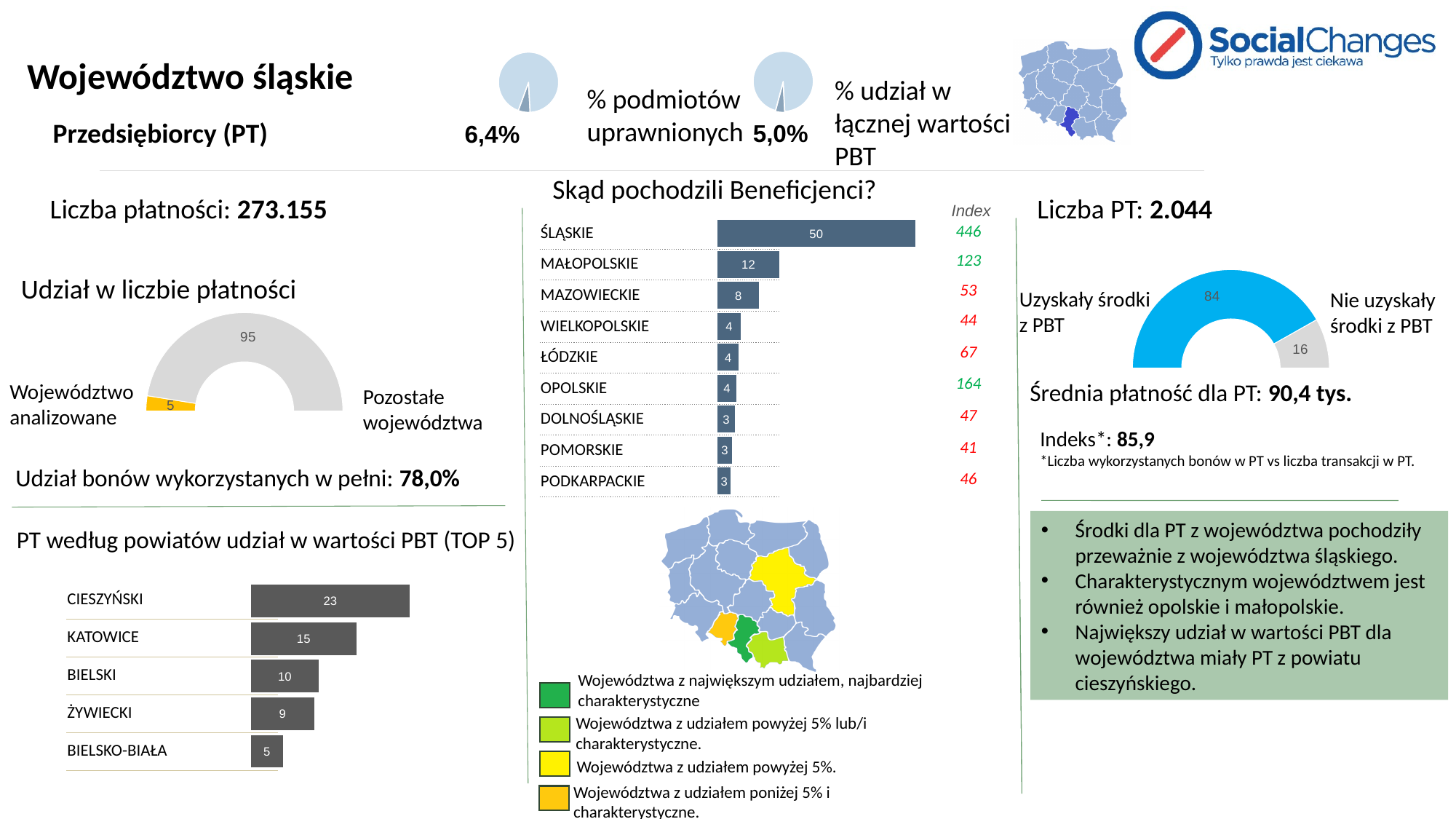
In the 'Skąd pochodzili Beneficjenci?' chart, which voivodeship has the highest value? ŚLĄSKIE In the 'Skąd pochodzili Beneficjenci?' chart, what is the value for ŚLĄSKIE? 50 In the 'Udział w liczbie płatności' chart, what is the value for 'Pozostałe województwa'? 95 What kind of chart is 'PT według powiatów udział w wartości PBT (TOP 5)'? Bar chart In the 'PT według powiatów udział w wartości PBT (TOP 5)' chart, which is larger: CIESZYŃSKI or BIELSKI? CIESZYŃSKI In the chart next to 'Liczba PT: 2.044', what is the difference between 'Uzyskały środki z PBT' and 'Nie uzyskały środki z PBT'? 68 In the 'Skąd pochodzili Beneficjenci?' chart, how many voivodeships are listed? 9 In the 'Skąd pochodzili Beneficjenci?' chart, what is the Index value shown for OPOLSKIE? 164 In the 'PT według powiatów udział w wartości PBT (TOP 5)' chart, what is the value for KATOWICE? 15 In the 'Skąd pochodzili Beneficjenci?' chart, what is the difference between the values for ŚLĄSKIE and MAŁOPOLSKIE? 38 In the chart next to 'Liczba PT: 2.044', what is the value for 'Uzyskały środki z PBT'? 84 In the 'PT według powiatów udział w wartości PBT (TOP 5)' chart, which powiat has the lowest value? BIELSKO-BIAŁA